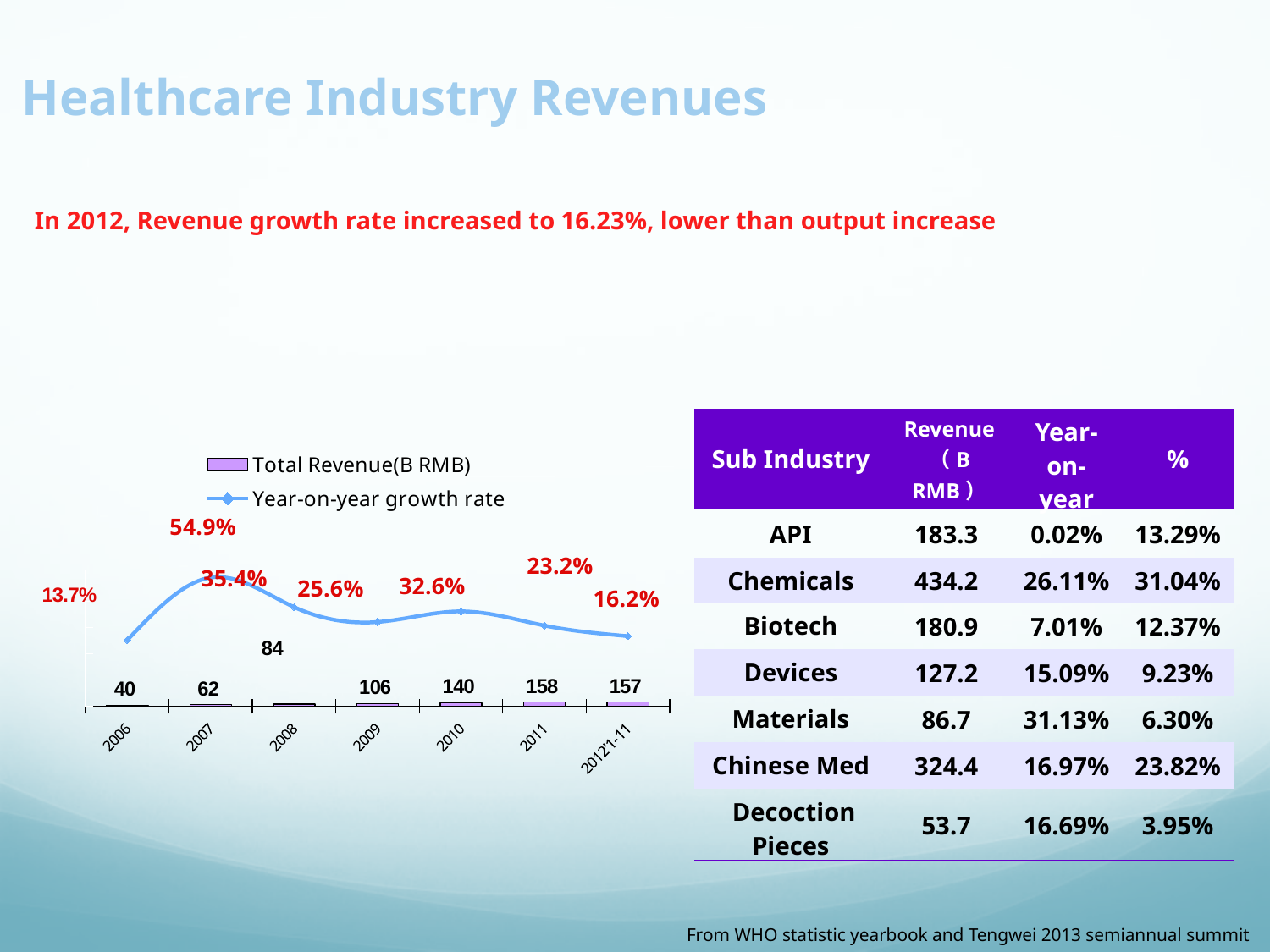
What is the Year-on-year growth rate for 2012'1-11? 16.2% What is the Total Revenue (B RMB) for 2010? 140 Which year has the highest Year-on-year growth rate? 2007 Which year has the lowest Total Revenue (B RMB)? 2006 What is the Year-on-year growth rate for 2007? 54.9% What type of chart is shown on the slide? Combined bar and line chart What is the difference in Total Revenue (B RMB) between 2011 and 2006? 118 Which is larger, the Year-on-year growth rate in 2010 or in 2011? 2010 Does the Year-on-year growth rate rise or fall from 2010 to 2012'1-11? Fall How many series does the chart legend list? 2 What is the Total Revenue (B RMB) for 2006? 40 How many years are shown on the x axis of the chart? 7